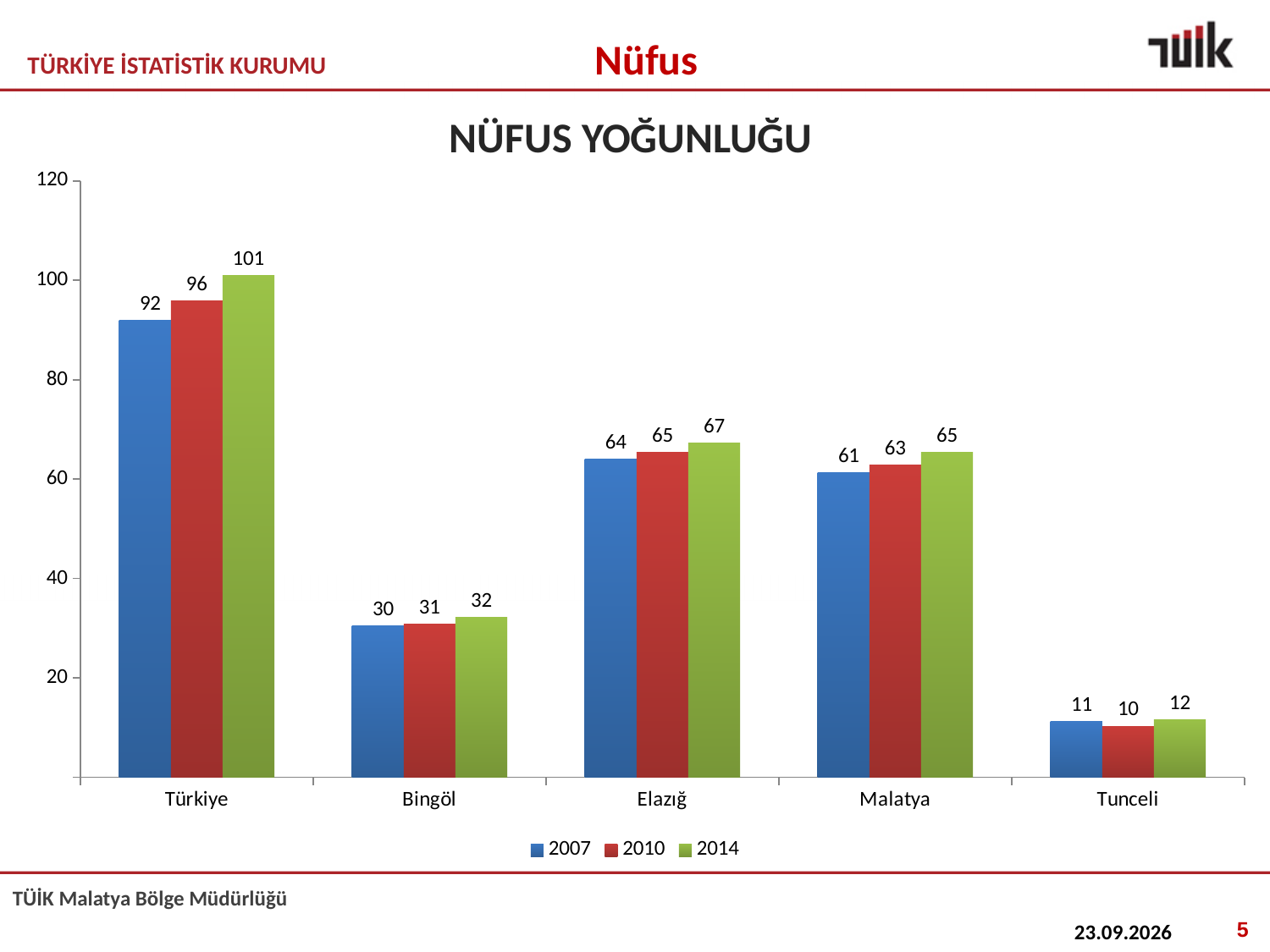
What is the difference between the 2014 and 2007 values for Türkiye? 9 What is the population density value for Elazığ in 2014? 67 What kind of chart is shown on the slide? bar chart Which is larger, the 2014 value for Elazığ or the 2014 value for Malatya? Elazığ What is the value for Türkiye in 2007? 92 What is the value for Tunceli in 2010? 10 Which category has the highest value in 2014? Türkiye Is the 2010 value for Bingöl greater or less than 40? less Which category has the lowest value in 2007? Tunceli How many categories are shown on the x axis? 5 What is the title of the chart? NÜFUS YOĞUNLUĞU How many series does the legend list? 3